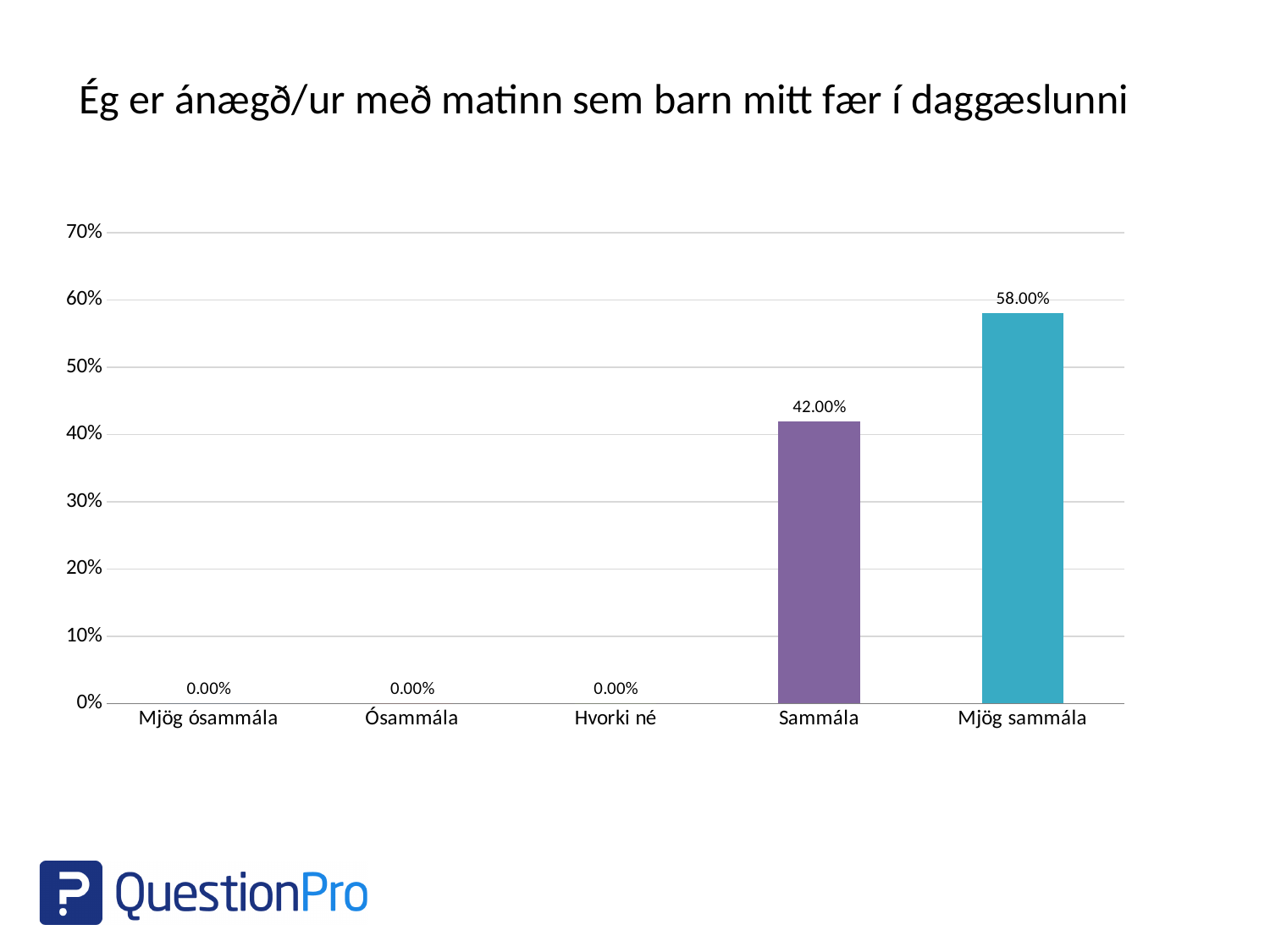
What is the value for Mjög sammála? 58.00% Which category has the highest value? Mjög sammála Is the value for Sammála greater or less than 40%? greater What is the title of the chart? Ég er ánægð/ur með matinn sem barn mitt fær í daggæslunni How many categories are shown on the x axis? 5 What kind of chart is shown on the slide? Bar chart Is the value for Mjög sammála greater or less than 60%? less Which is larger, the value for Sammála or the value for Mjög sammála? Mjög sammála What is the difference between the values for Mjög sammála and Sammála? 16.00% What is the value for Hvorki né? 0.00% Do the values rise or fall from left to right along the x axis? Rise What is the value for Sammála? 42.00%